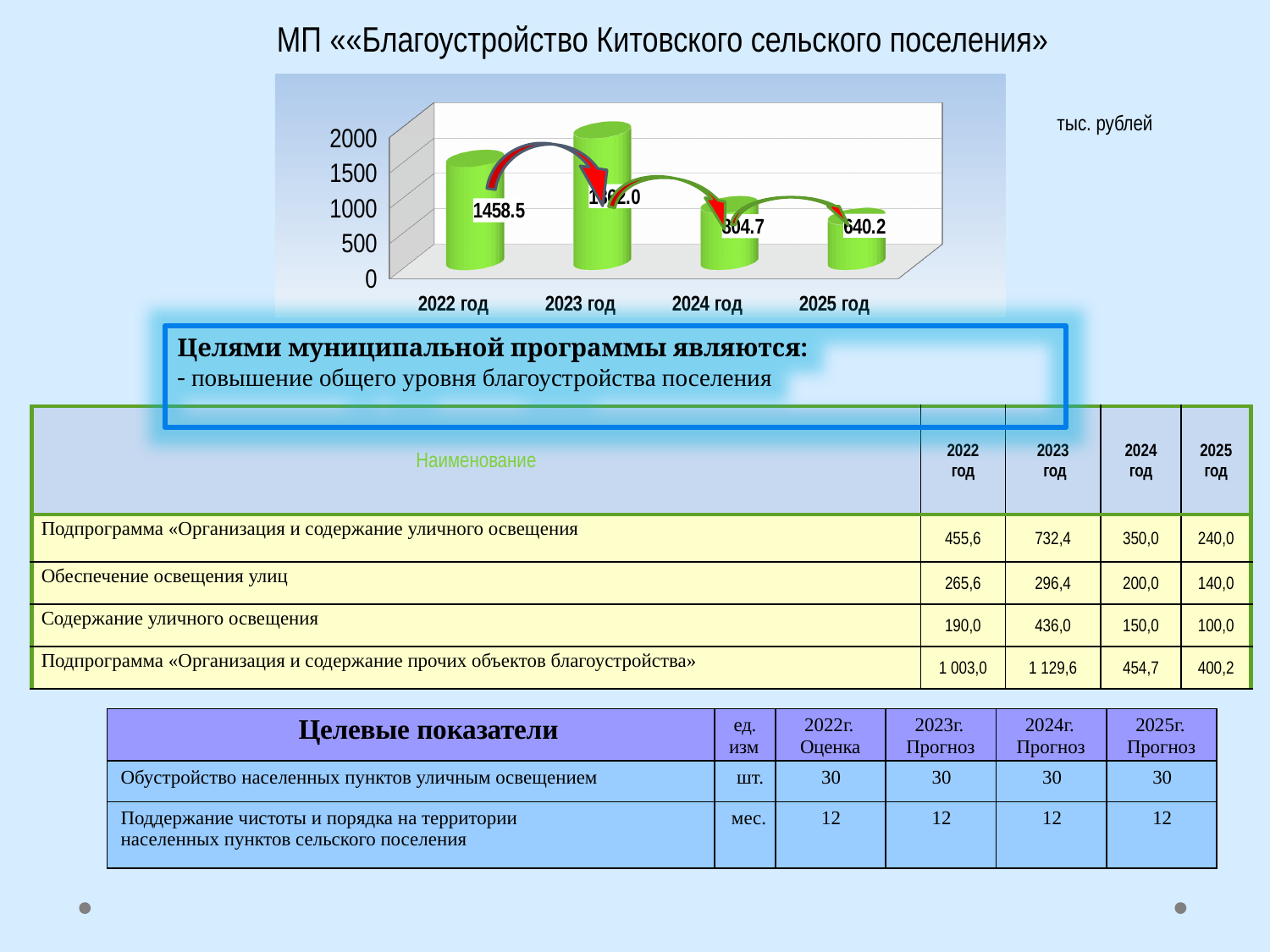
Which is larger, the value for 2022 год or the value for 2025 год? 2022 год Is the value for 2023 год greater or less than 1500? greater What unit is indicated next to the chart? тыс. рублей Which year has the lowest bar? 2025 год What kind of chart is shown on the slide? bar chart Do the values rise or fall from 2023 год to 2025 год? fall Is the value for 2024 год greater or less than 1000? less Which year has the highest bar? 2023 год What is the value for 2025 год? 640.2 How many years are shown on the x axis of the chart? 4 What is the difference between the values for 2022 год and 2025 год? 818.3 What is the value for 2022 год? 1458.5